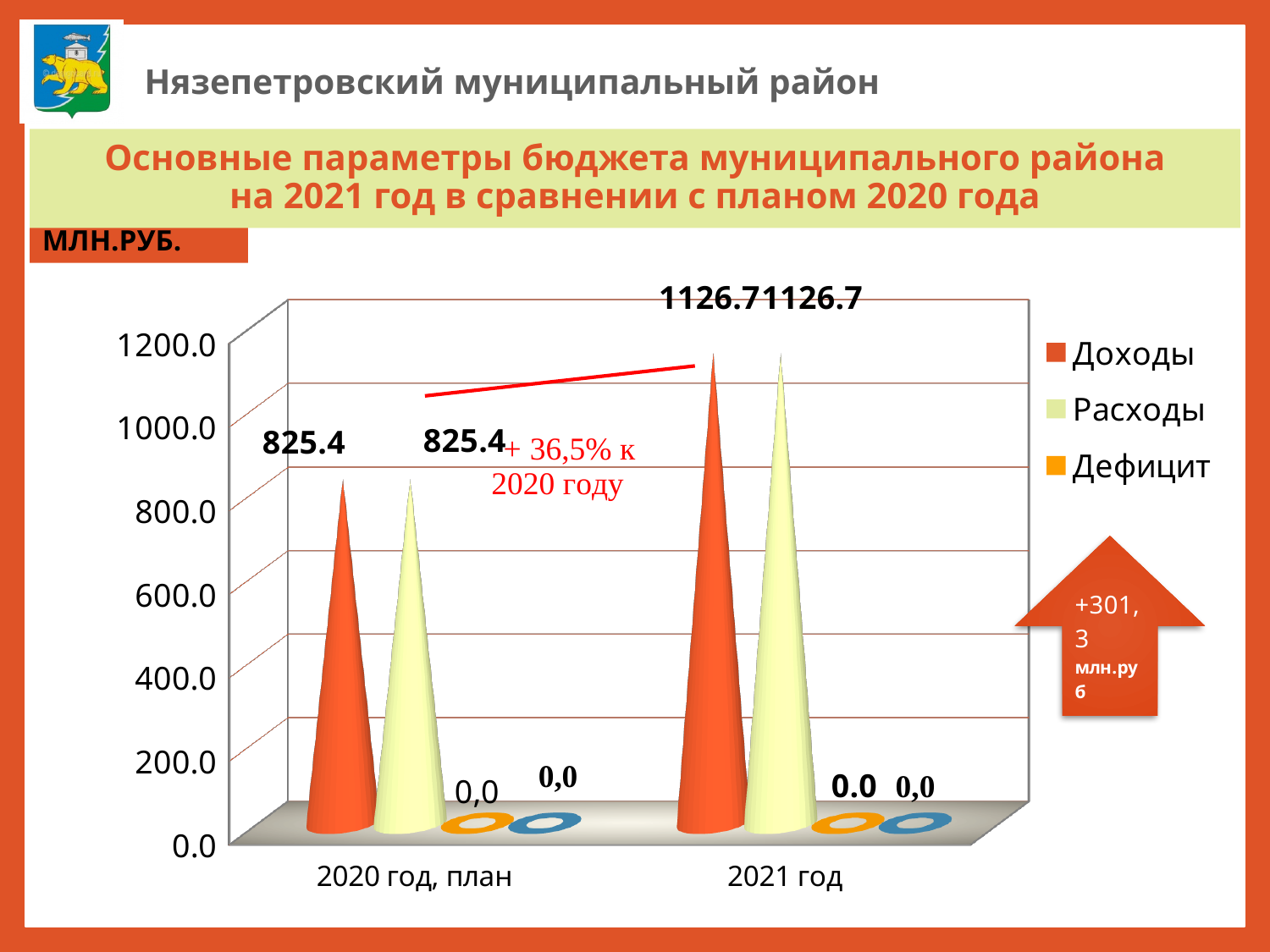
What is the value of Расходы for 2020 год, план? 825.4 How many series does the chart legend list? 3 What is the difference between Доходы in 2021 год and Доходы in 2020 год, план? 301.3 Is the value of Расходы for 2020 год, план greater or less than 1000.0? less What unit is indicated for the chart values on the slide? МЛН.РУБ. Is the value of Доходы for 2021 год greater or less than 1000.0? greater What is the value of Доходы for 2021 год? 1126.7 Do the Доходы values rise or fall from 2020 год, план to 2021 год? rise What is the value of Дефицит for 2021 год? 0.0 What type of chart is shown on the slide? bar chart Which category has the higher value for Расходы: 2020 год, план or 2021 год? 2021 год How many categories are shown on the x axis of the chart? 2